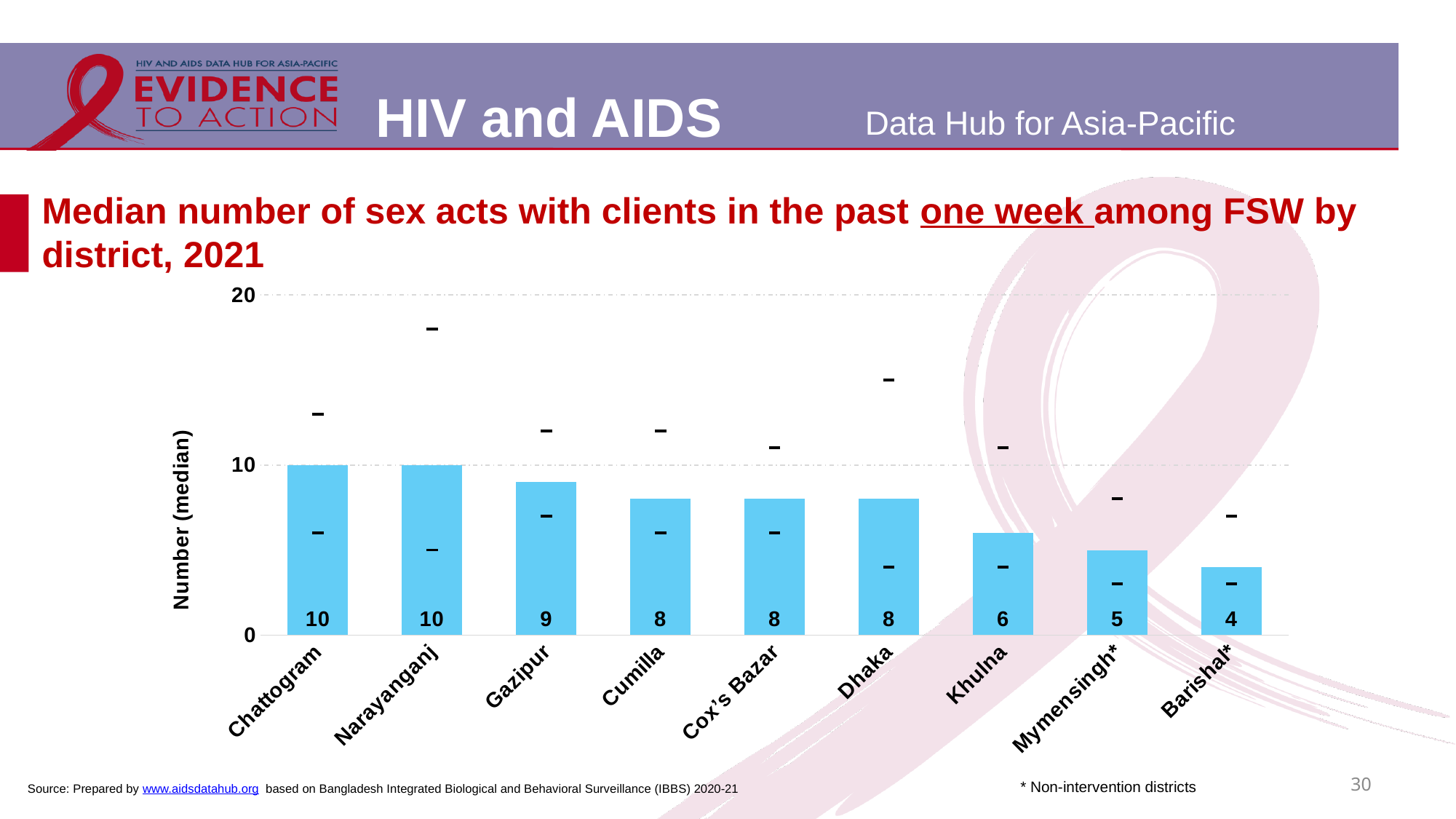
What is the label of the y axis on the chart? Number (median) What is the difference between the median values for Chattogram and Mymensingh*? 5 What is the median number of sex acts with clients in the past one week among FSW in Barishal*? 4 Which has a higher median number of sex acts in the past one week, Gazipur or Khulna? Gazipur Do the median values rise or fall moving from Chattogram to Barishal* along the x axis? fall What is the median number of sex acts with clients in the past one week among FSW in Gazipur? 9 What is the median number of sex acts with clients in the past one week among FSW in Dhaka? 8 What type of chart is used to show the median number of sex acts by district? bar chart Is the median value for Cumilla greater or less than 10? less How many districts are shown on the chart? 9 Which district has the lowest median number of sex acts with clients in the past one week? Barishal* What is the median number of sex acts with clients in the past one week among FSW in Khulna? 6